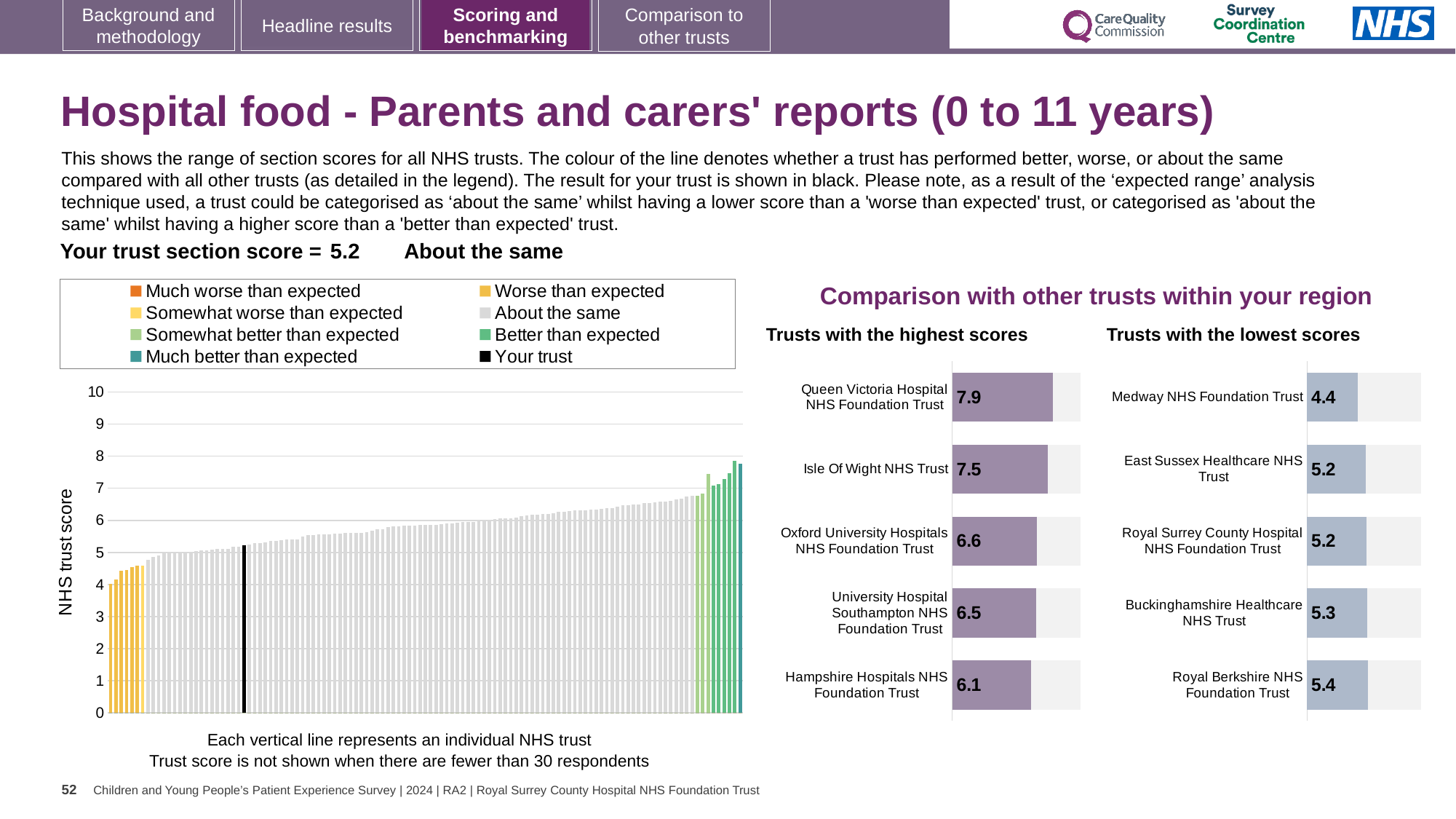
In the main chart on the left, how many entries does the legend list? 8 In the main chart on the left, do the trust scores rise or fall from left to right? rise In the 'Trusts with the lowest scores' chart, which has the larger score, Medway NHS Foundation Trust or Buckinghamshire Healthcare NHS Trust? Buckinghamshire Healthcare NHS Trust In the 'Trusts with the lowest scores' chart, which trust has the lowest score? Medway NHS Foundation Trust In the main chart on the left, is the value of the tallest bar greater or less than 7? greater In the main chart on the left, what kind of chart is used to show the NHS trust scores? bar chart In the main chart on the left, what is the label on the vertical axis? NHS trust score In the 'Trusts with the highest scores' chart, which trust has the highest score? Queen Victoria Hospital NHS Foundation Trust In the 'Trusts with the highest scores' chart, what is the difference between the scores of Queen Victoria Hospital NHS Foundation Trust and Hampshire Hospitals NHS Foundation Trust? 1.8 In the main chart on the left, what is the section score for your trust (the black bar)? 5.2 In the 'Trusts with the highest scores' chart, what is the score for Isle Of Wight NHS Trust? 7.5 In the 'Trusts with the lowest scores' chart, how many trusts are shown? 5